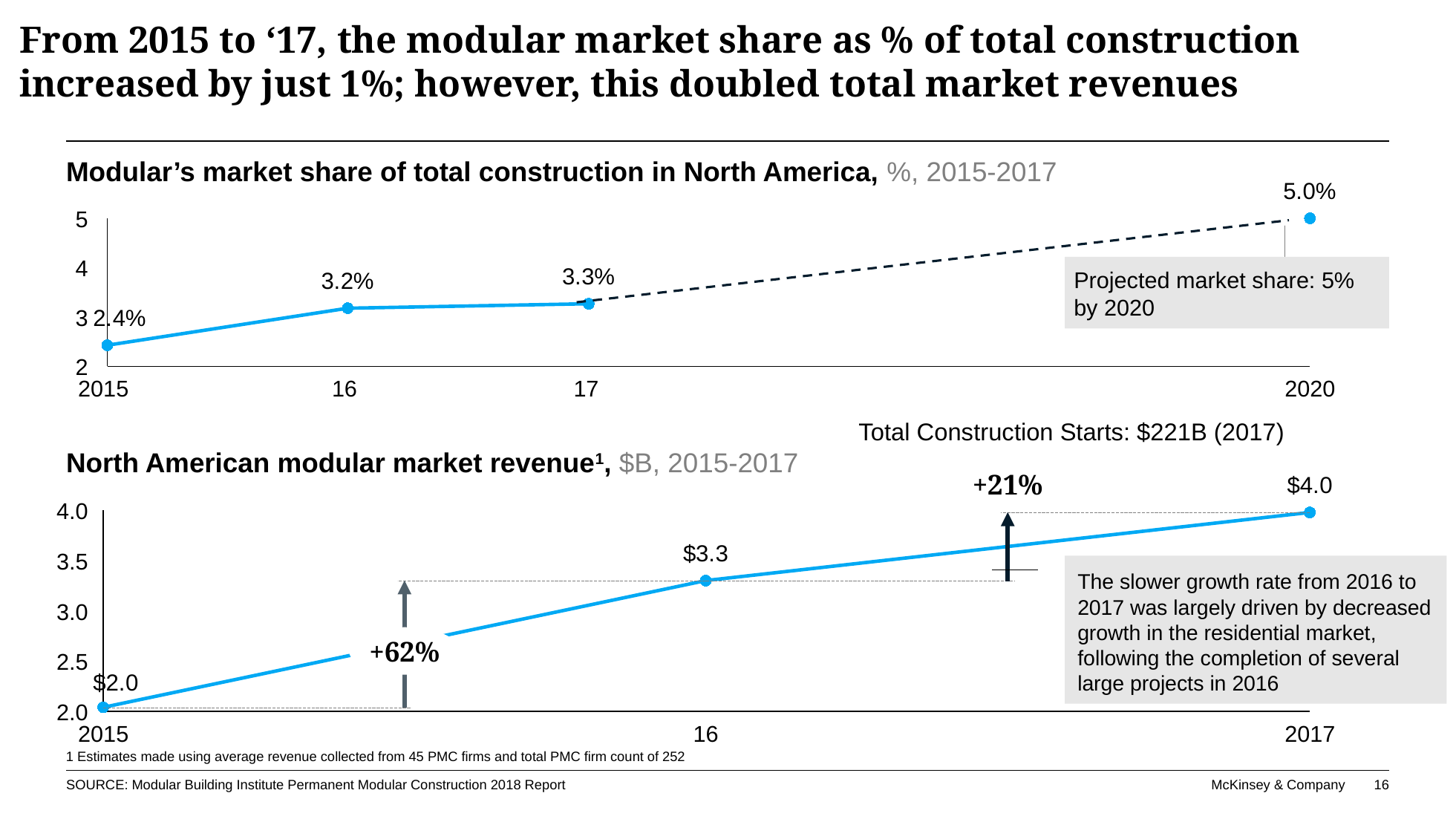
In the 'Modular's market share of total construction in North America' chart, what kind of chart is it? line chart In the 'North American modular market revenue' chart, what is the value for 2016? $3.3 In the 'North American modular market revenue' chart, what percentage growth is shown between 2015 and 2016? +62% In the 'Modular's market share of total construction in North America' chart, which year has the lowest market share? 2015 In the 'North American modular market revenue' chart, what is the difference between the 2017 and 2015 values? $2.0 In the 'North American modular market revenue' chart, do values rise or fall from 2015 to 2017? rise In the 'Modular's market share of total construction in North America' chart, how many data points are plotted? 4 In the 'Modular's market share of total construction in North America' chart, what is the value for 2017? 3.3% In the 'Modular's market share of total construction in North America' chart, what is the projected value for 2020? 5.0% In the 'North American modular market revenue' chart, what is the value for 2017? $4.0 In the 'Modular's market share of total construction in North America' chart, what is the value for 2015? 2.4% In the 'North American modular market revenue' chart, which year has the highest revenue? 2017